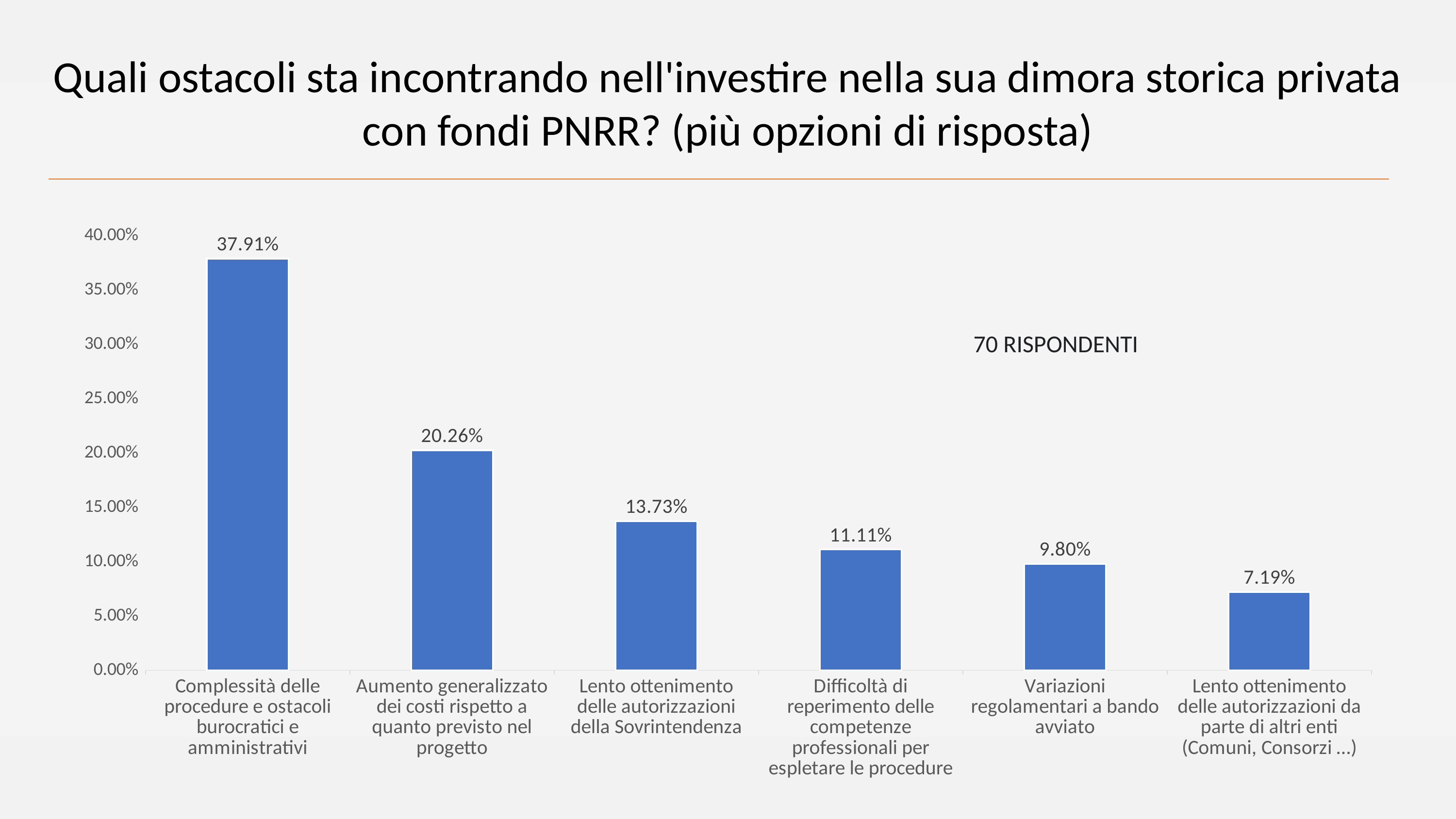
Which is larger: the value for 'Difficoltà di reperimento delle competenze professionali per espletare le procedure' or the value for 'Variazioni regolamentari a bando avviato'? Difficoltà di reperimento delle competenze professionali per espletare le procedure What is the value for 'Lento ottenimento delle autorizzazioni della Sovrintendenza'? 13.73% What is the difference between the values for 'Complessità delle procedure e ostacoli burocratici e amministrativi' and 'Aumento generalizzato dei costi rispetto a quanto previsto nel progetto'? 17.65% Which category has the lowest value? Lento ottenimento delle autorizzazioni da parte di altri enti (Comuni, Consorzi …) What kind of chart is shown on the slide? bar chart What is the value for 'Complessità delle procedure e ostacoli burocratici e amministrativi'? 37.91% How many categories are shown in the chart? 6 What is the value for 'Variazioni regolamentari a bando avviato'? 9.80% Do the values rise or fall from left to right along the x axis? fall How many respondents does the chart note indicate? 70 Which category has the highest value? Complessità delle procedure e ostacoli burocratici e amministrativi Is the value for 'Aumento generalizzato dei costi rispetto a quanto previsto nel progetto' greater or less than 20.00%? greater